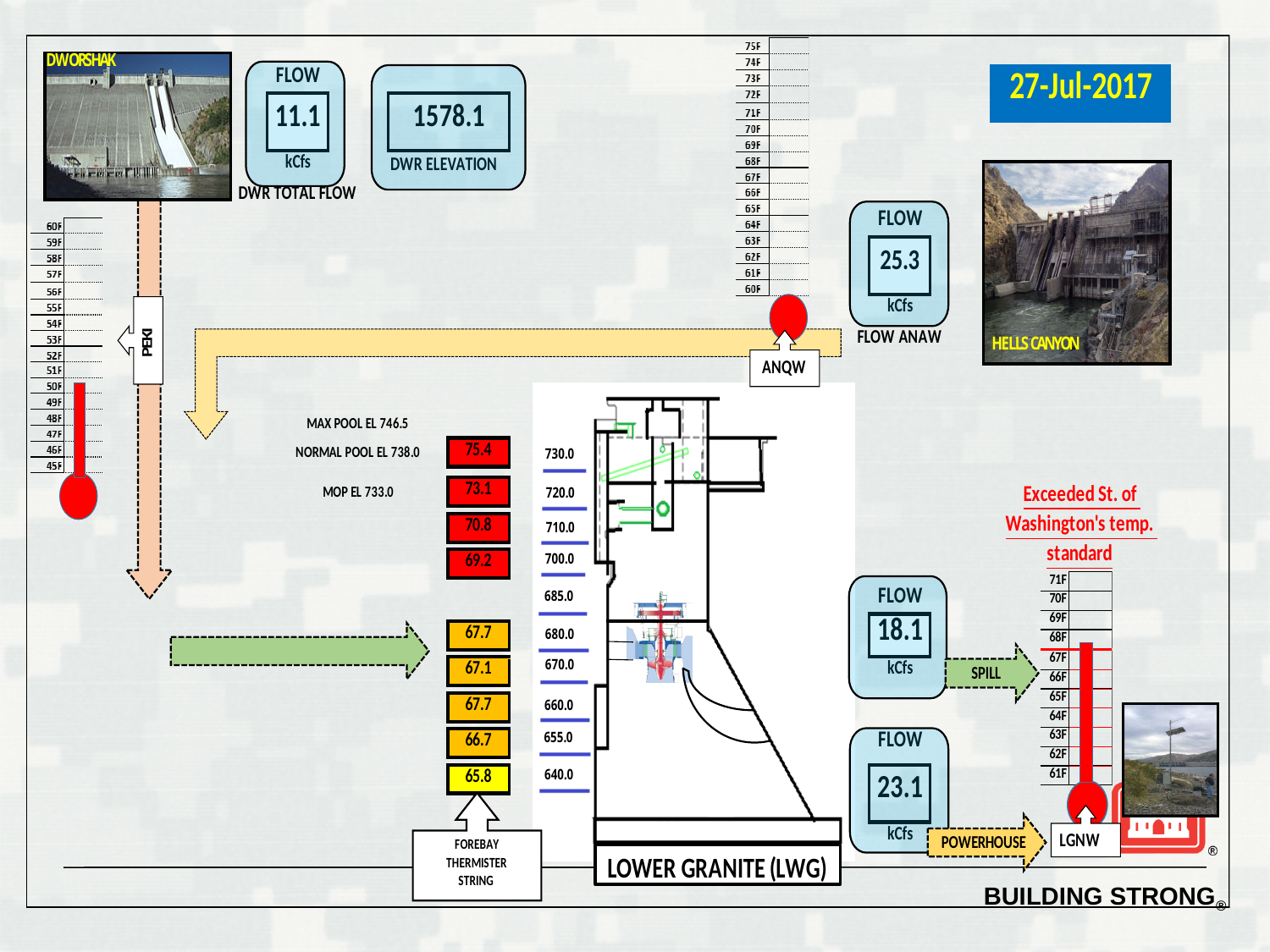
What is the spill flow value shown for Lower Granite? 18.1 kCfs On the forebay thermistor string, what temperature is shown at elevation 700.0? 69.2 On the forebay thermistor string, what temperature is shown at elevation 640.0? 65.8 What is the DWR total flow value shown in the flow gauge? 11.1 kCfs On the forebay thermistor string, which reading is larger, the one at 720.0 or the one at 670.0? 720.0 On the forebay thermistor string, which elevation has the highest temperature reading? 730.0 Which is larger, the powerhouse flow or the spill flow at Lower Granite? powerhouse flow On the forebay thermistor string, what temperature is shown at elevation 730.0? 75.4 Do the forebay thermistor string readings rise or fall as elevation decreases from 730.0 to 640.0? fall On the forebay thermistor string, which elevation has the lowest temperature reading? 640.0 How many temperature readings are shown on the forebay thermistor string? 9 On the forebay thermistor string, what is the difference between the readings at 730.0 and 640.0? 9.6